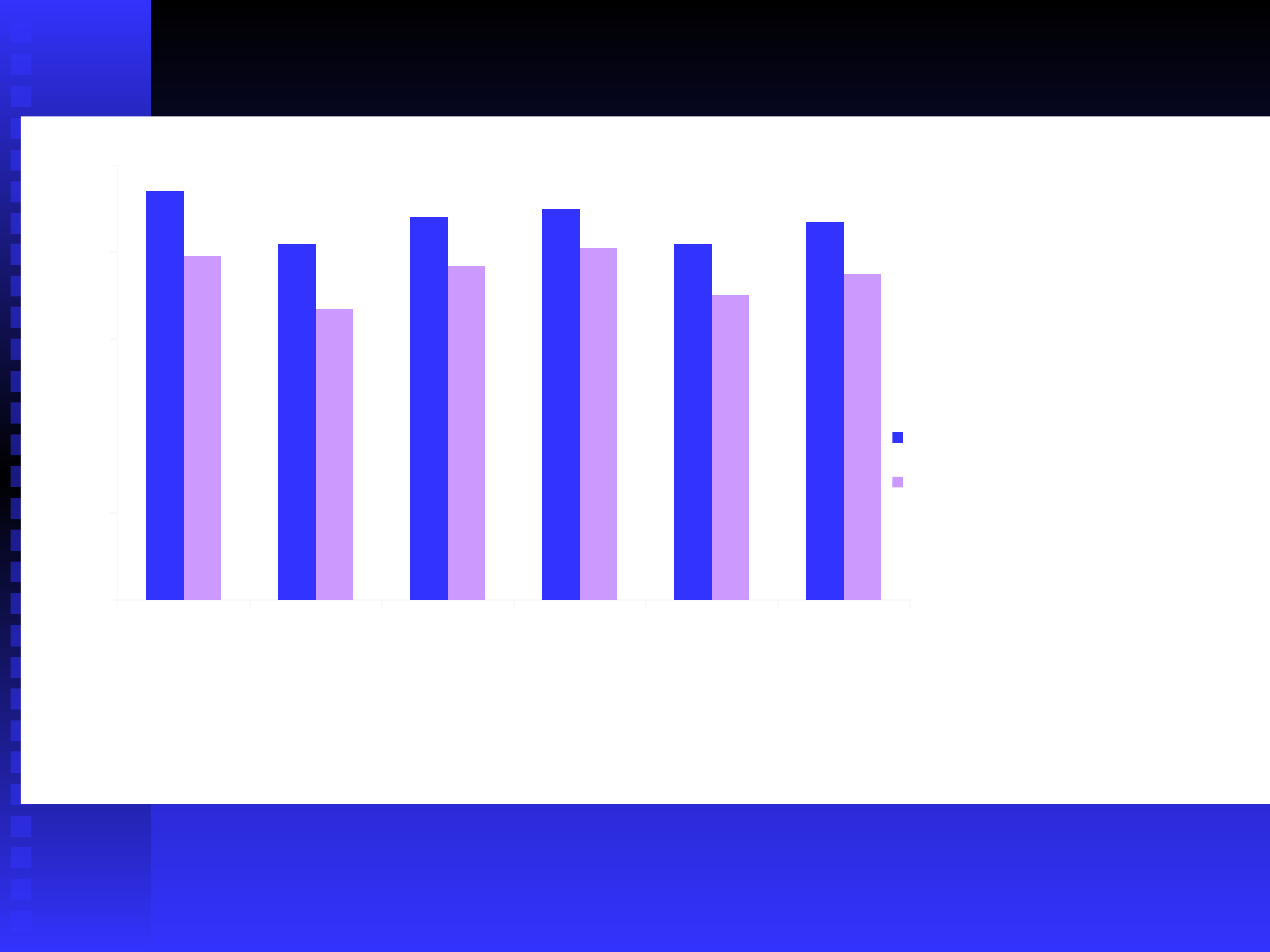
How many groups of bars are plotted along the x axis? 6 How many series does the legend list? 2 Which group of bars, counting from the left, has the shortest light purple bar? the second group In the leftmost group of bars, which bar is taller, the dark blue one or the light purple one? the dark blue one Where is the legend positioned relative to the plotted bars? to the right of the bars What kind of chart is shown on the slide? bar chart What two colours are used for the bars in the chart? dark blue and light purple Which group of bars, counting from the left, has the tallest dark blue bar? the first group In every group, is the dark blue bar taller or shorter than the light purple bar? taller